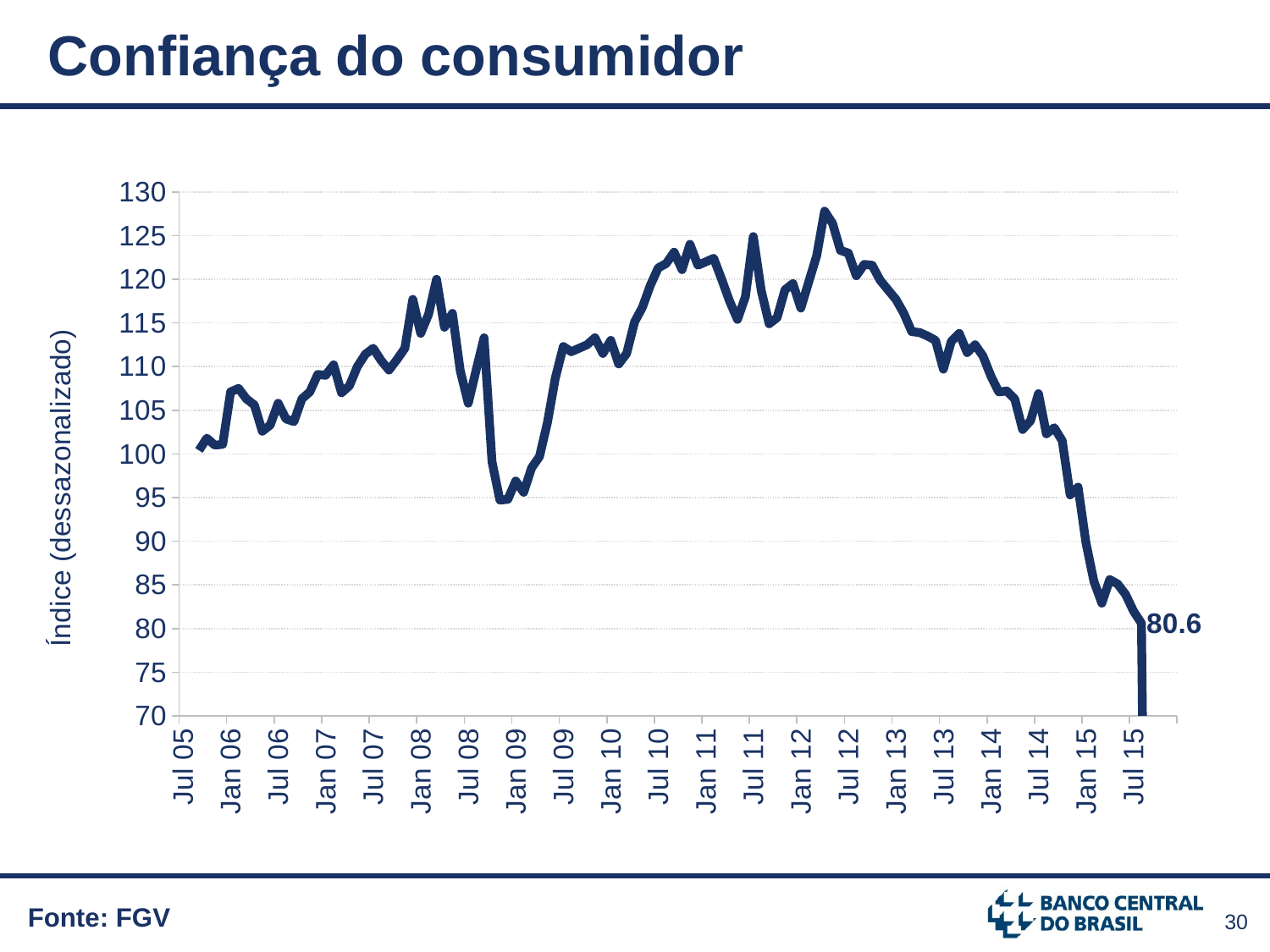
Is the highest point of the line greater or less than 125? greater What is the label on the vertical axis? Índice (dessazonalizado) Is the value of the index at Jul 12 greater or less than 120? greater Does the index rise or fall overall between Jul 05 and Jan 08? rise Does the index rise or fall between Jan 15 and Jul 15? fall What is the title of the chart? Confiança do consumidor Is the value of the index at Jul 14 greater or less than 110? less How many date labels are shown on the horizontal axis? 21 What value is printed on the data label at the end of the line? 80.6 What kind of chart is shown on the slide? line chart